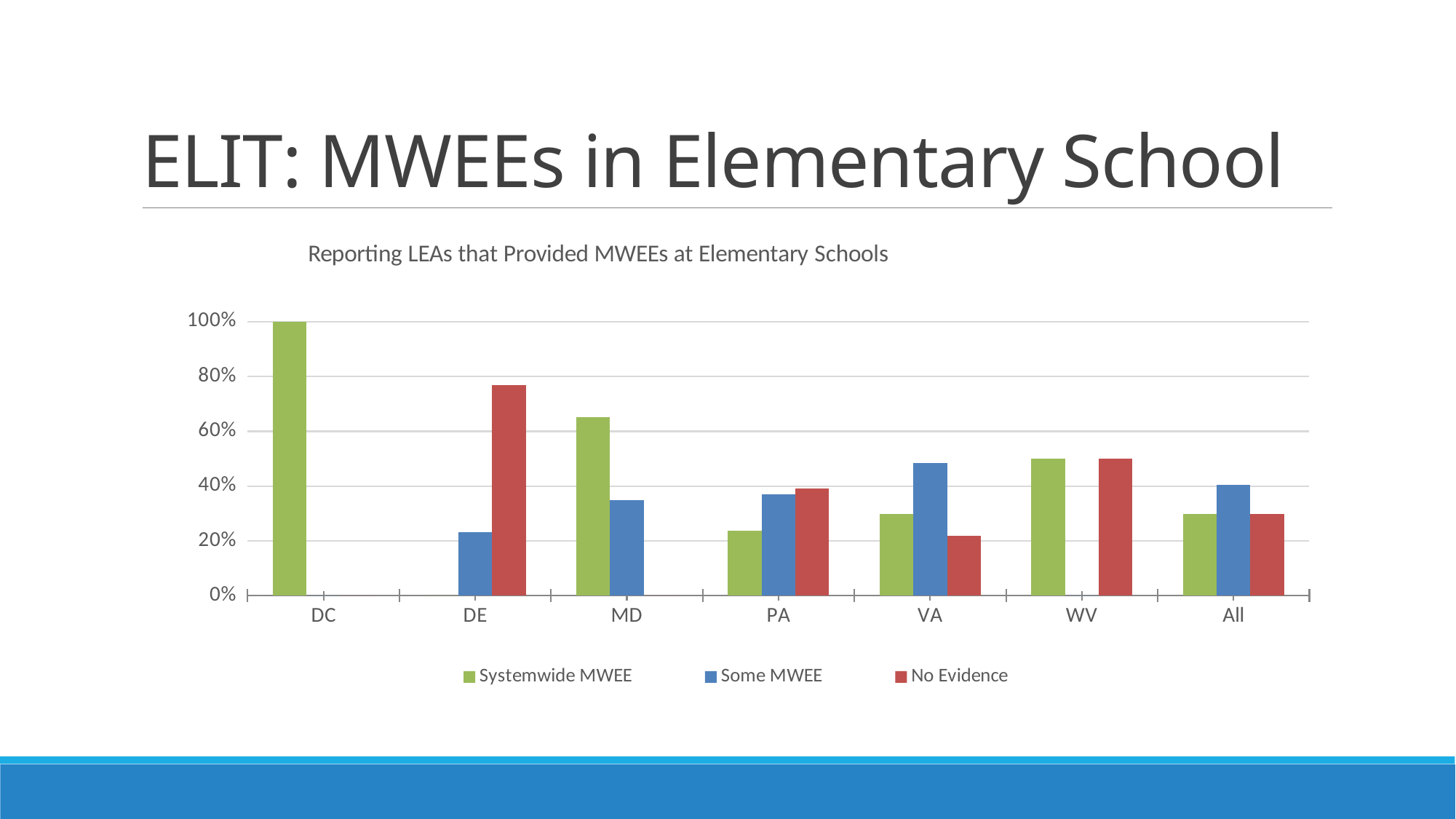
What is the title of the chart? Reporting LEAs that Provided MWEEs at Elementary Schools For PA, which is larger: Some MWEE or Systemwide MWEE? Some MWEE How many categories are shown along the x axis? 7 What kind of chart is shown on the slide? bar chart Is the No Evidence value for VA greater or less than 40%? less Which category has the highest No Evidence value? DE Is the Systemwide MWEE value for All greater or less than 40%? less How many series does the legend list? 3 Which category has the highest Systemwide MWEE value? DC What is the Systemwide MWEE value for DC? 100% Is the No Evidence value for DE greater or less than 60%? greater For All, which is larger: Some MWEE or No Evidence? Some MWEE